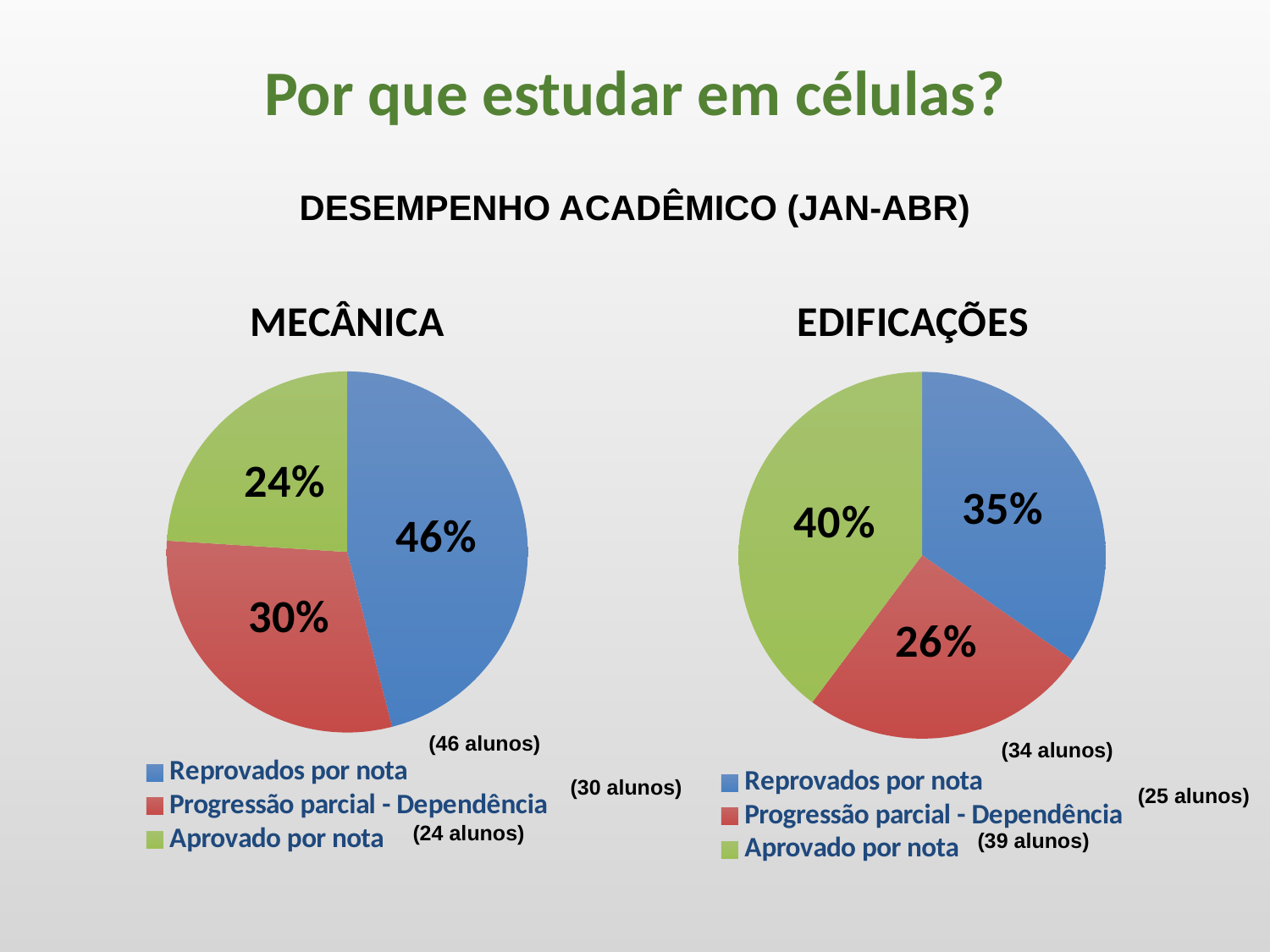
In the EDIFICAÇÕES chart, which category has the smallest slice? Progressão parcial - Dependência How many slices does the EDIFICAÇÕES pie chart have? 3 In the MECÂNICA chart, what share is Reprovados por nota? 46% In the MECÂNICA chart, what share is Aprovado por nota? 24% What kind of chart is the MECÂNICA chart? Pie chart In the MECÂNICA chart, what share is Progressão parcial - Dependência? 30% Which chart has the larger share of Aprovado por nota, MECÂNICA or EDIFICAÇÕES? EDIFICAÇÕES What is the difference in percentage points between Reprovados por nota and Aprovado por nota in the MECÂNICA chart? 22 percentage points In the MECÂNICA chart, which category has the largest slice? Reprovados por nota